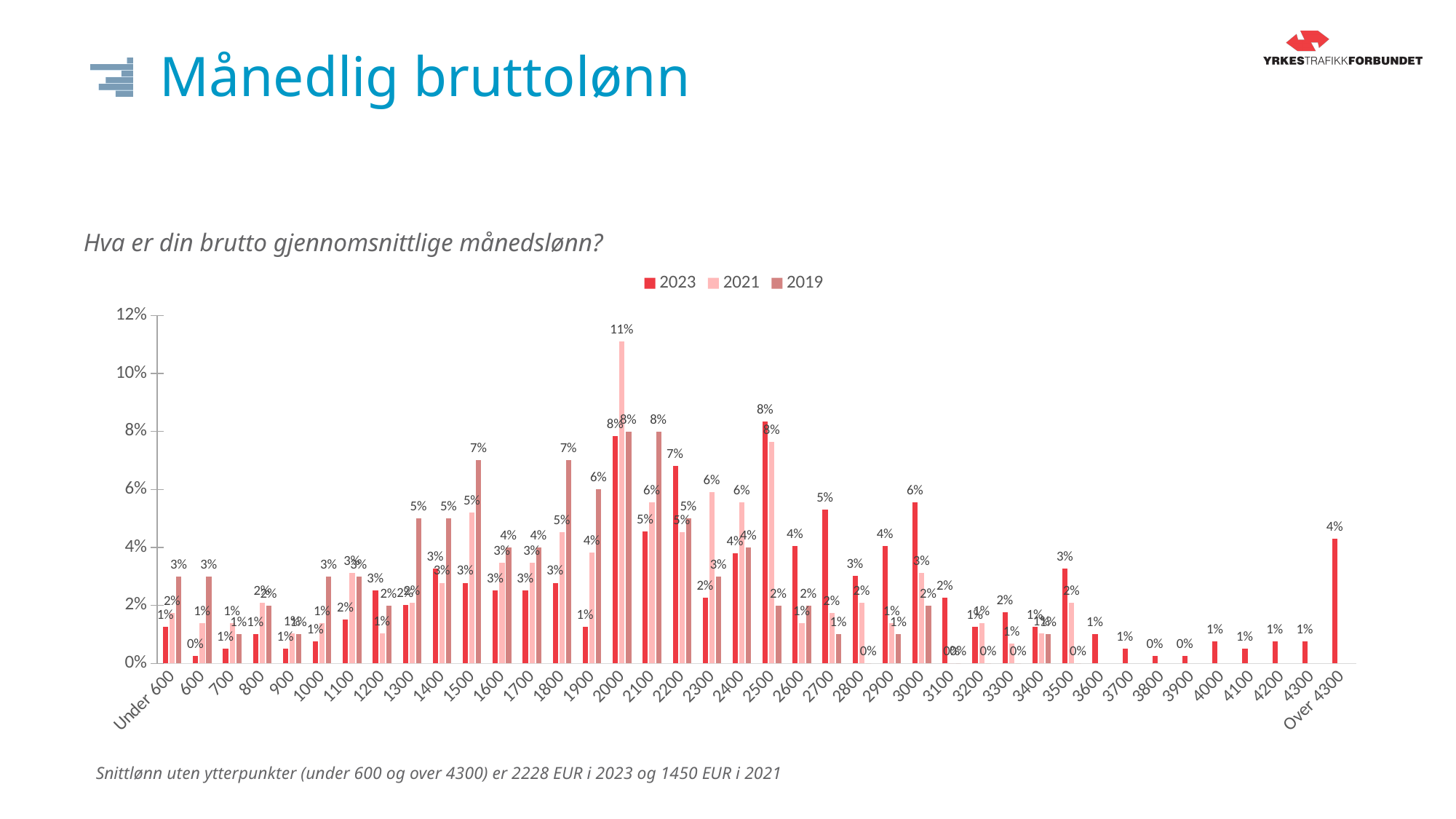
What is the value for 2021 in the 2000 category? 11% What kind of chart is shown on the slide? bar chart How many categories are shown on the x axis? 40 Which category has the highest value for the 2021 series? 2000 What are the series listed in the legend? 2023, 2021, 2019 What is the value for 2023 in the 2700 category? 5% For the 2023 series, which is larger: the value for 2200 or the value for 3000? 2200 How many series does the legend list? 3 What is the value for 2023 in the 2500 category? 8% What is the value for 2023 in the Over 4300 category? 4% What is the value for 2019 in the 2100 category? 8% Is the value for 2021 in the 2000 category greater or less than 10%? greater